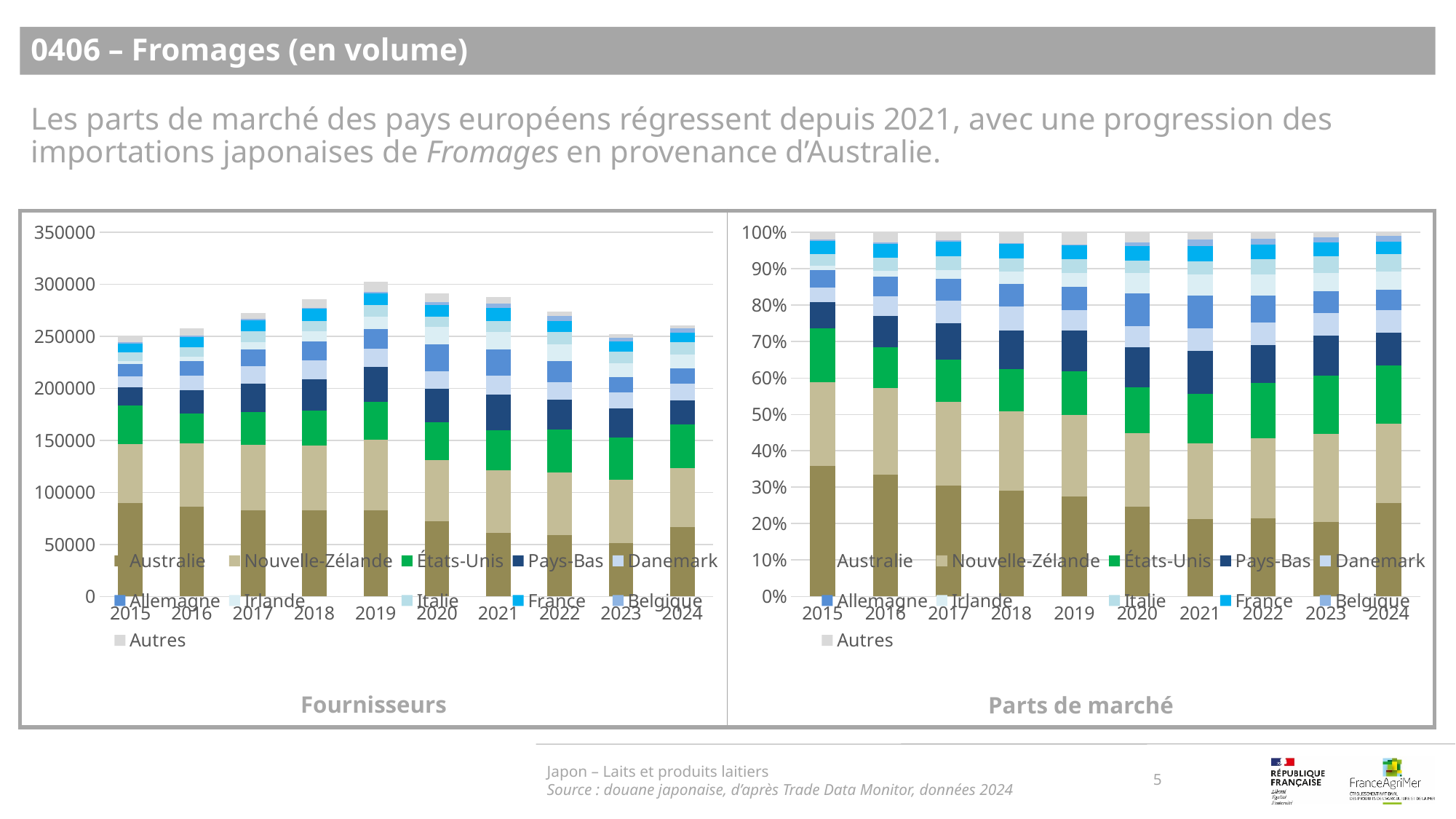
In the 'Fournisseurs' chart, is the total bar for 2019 greater or less than 250000? greater In the 'Fournisseurs' chart, is the total bar for 2023 greater or less than 300000? less What kind of chart is the 'Fournisseurs' chart on the left? Stacked bar chart Which series is listed first in the legend of the 'Fournisseurs' chart? Australie In the 'Parts de marché' chart, is the Australie share in 2023 greater or less than 30%? less In the 'Parts de marché' chart, is the Australie share larger in 2015 or in 2024? 2015 In the 'Parts de marché' chart, does the Australie share rise or fall from 2015 to 2023? fall What is the title shown under the right-hand chart? Parts de marché How many series does the legend of the 'Fournisseurs' chart list? 11 In the 'Fournisseurs' chart, which year has the tallest total bar? 2019 How many years are shown on the x axis of the 'Parts de marché' chart? 10